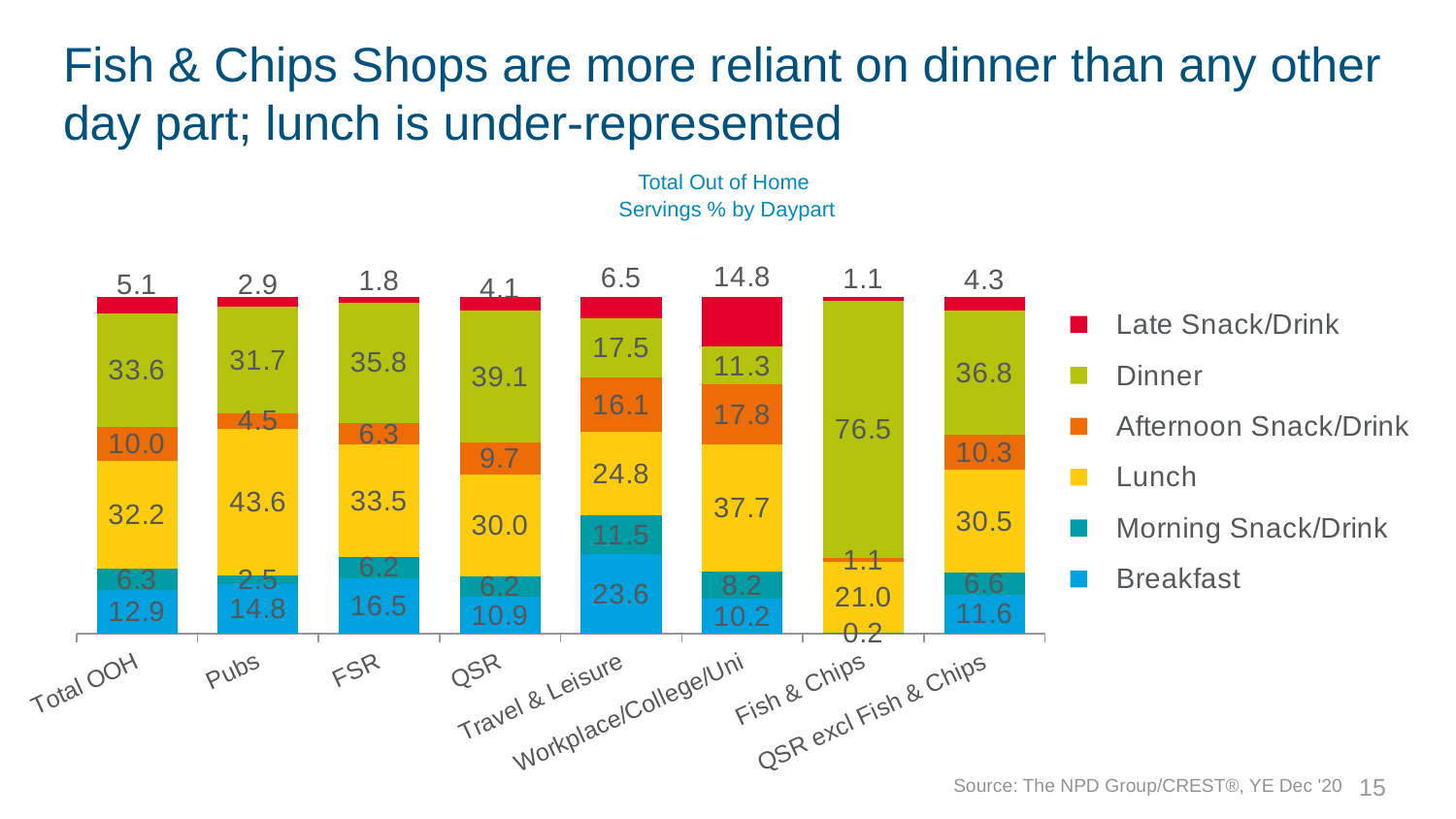
What is the difference between the Dinner value for Fish & Chips and the Dinner value for QSR excl Fish & Chips? 39.7 Which category has the lowest Late Snack/Drink value? Fish & Chips Which category has the highest Late Snack/Drink value? Workplace/College/Uni What kind of chart is shown on the slide? Stacked bar chart What is the Dinner value for Fish & Chips? 76.5 What is the Lunch value for Pubs? 43.6 Which category has the highest Dinner value? Fish & Chips How many series does the legend list? 6 How many categories are shown on the x axis? 8 Which has the larger Lunch value, Pubs or FSR? Pubs What is the Afternoon Snack/Drink value for Workplace/College/Uni? 17.8 What is the Breakfast value for Travel & Leisure? 23.6